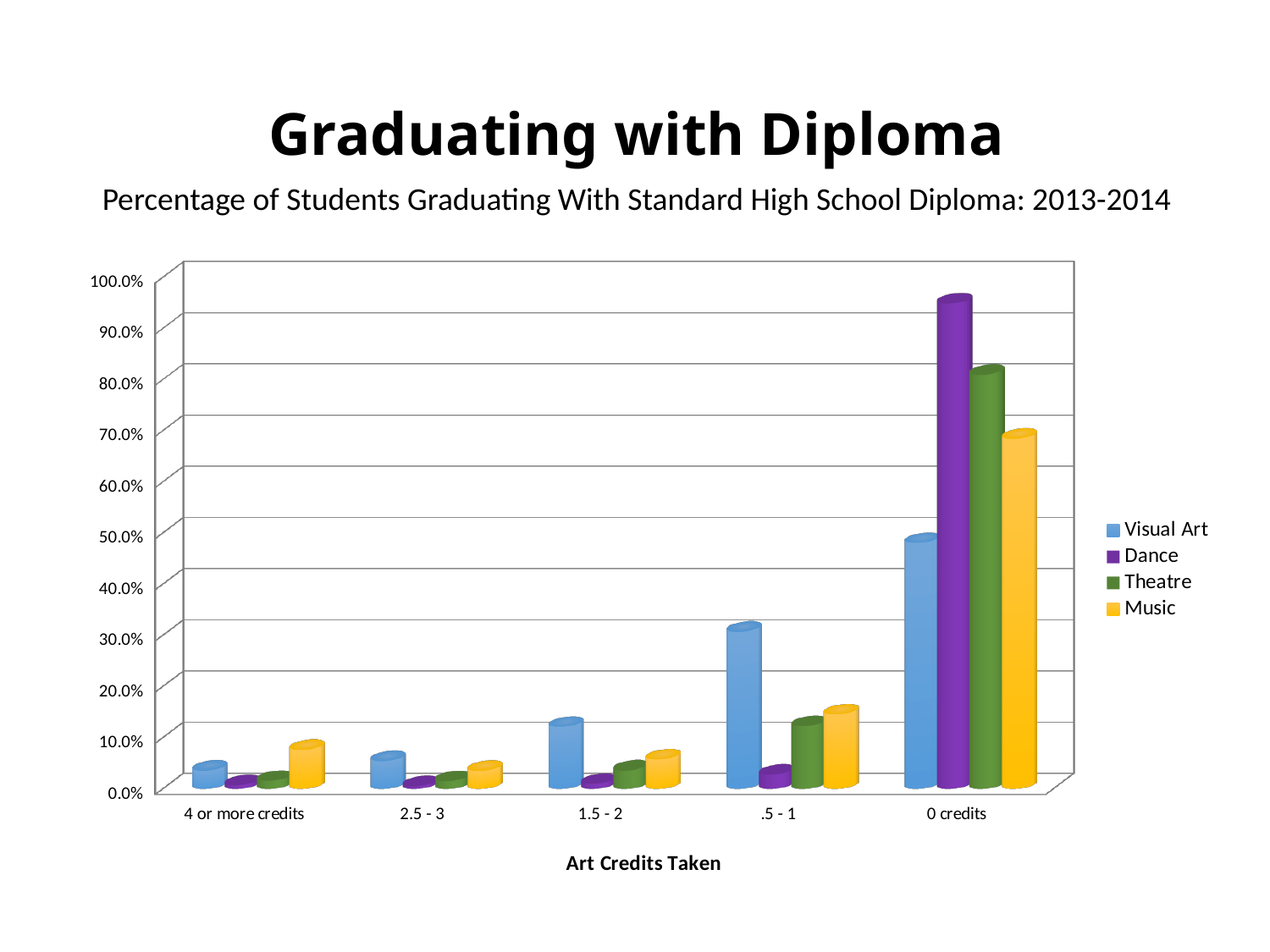
At 0 credits, which is larger: Dance or Theatre? Dance Is the value for Visual Art at .5 - 1 credits greater or less than 20%? greater Is the value for Theatre at 0 credits greater or less than 70%? greater How many series does the legend list? 4 At 0 credits, which series has the lowest value? Visual Art Which category has the highest value for Dance? 0 credits Is the value for Dance at 0 credits greater or less than 90%? greater What kind of chart is shown on the slide? bar chart What is the title of the x axis? Art Credits Taken How many categories are shown on the x axis? 5 Do the Visual Art values rise or fall moving from 4 or more credits to 0 credits along the x axis? rise